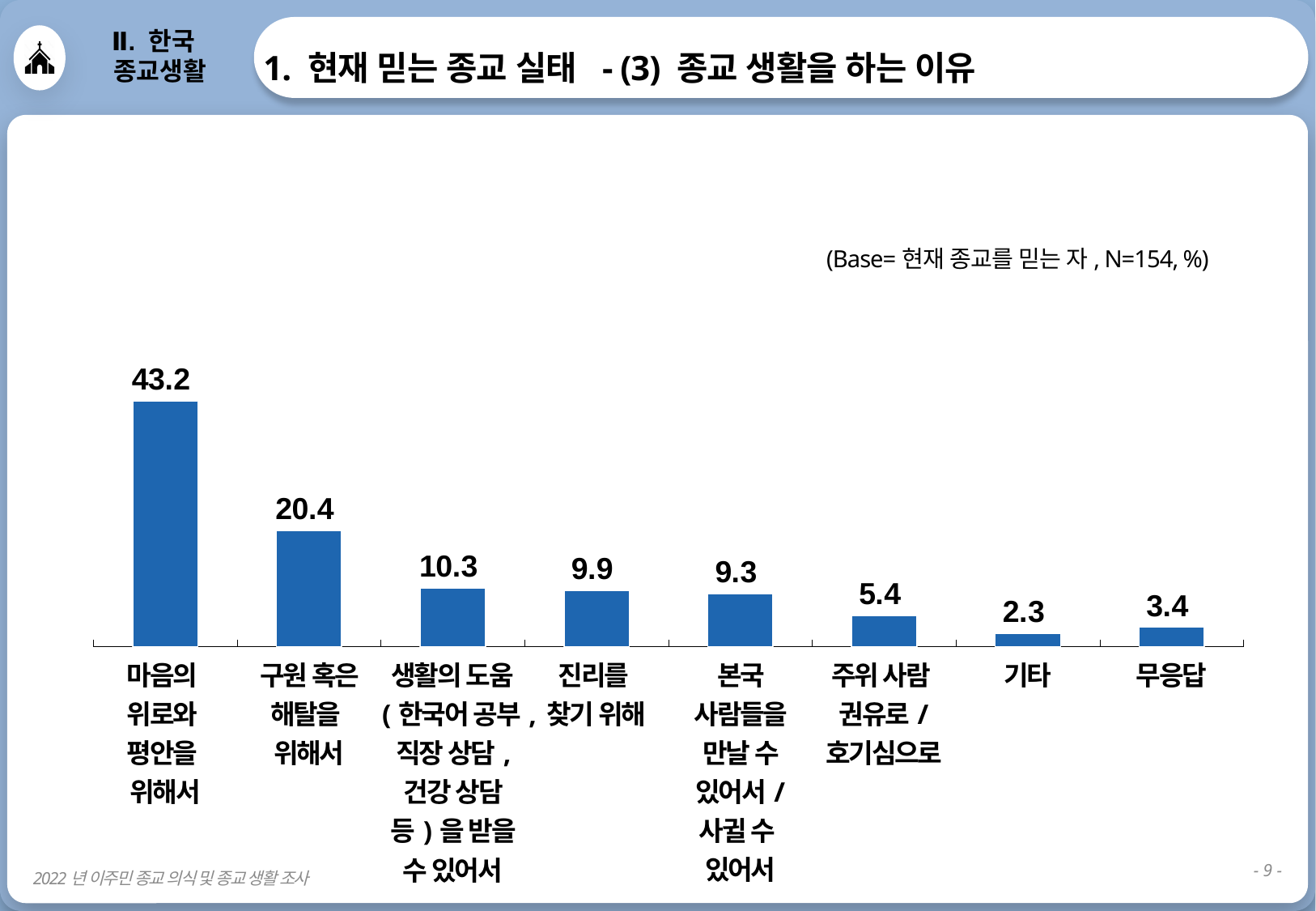
What kind of chart is shown on the slide? Bar chart How many categories are shown in the chart? 8 What is the value for '마음의 위로와 평안을 위해서'? 43.2 What is the base (N) stated for the chart? N=154 Which category has the highest value? 마음의 위로와 평안을 위해서 What is the difference between the values for '마음의 위로와 평안을 위해서' and '구원 혹은 해탈을 위해서'? 22.8 What is the value for '구원 혹은 해탈을 위해서'? 20.4 What is the value for '주위 사람 권유로 / 호기심으로'? 5.4 What is the value for '진리를 찾기 위해'? 9.9 Which is larger, the value for '기타' or the value for '무응답'? 무응답 What is the value for '무응답'? 3.4 Which category has the lowest value? 기타